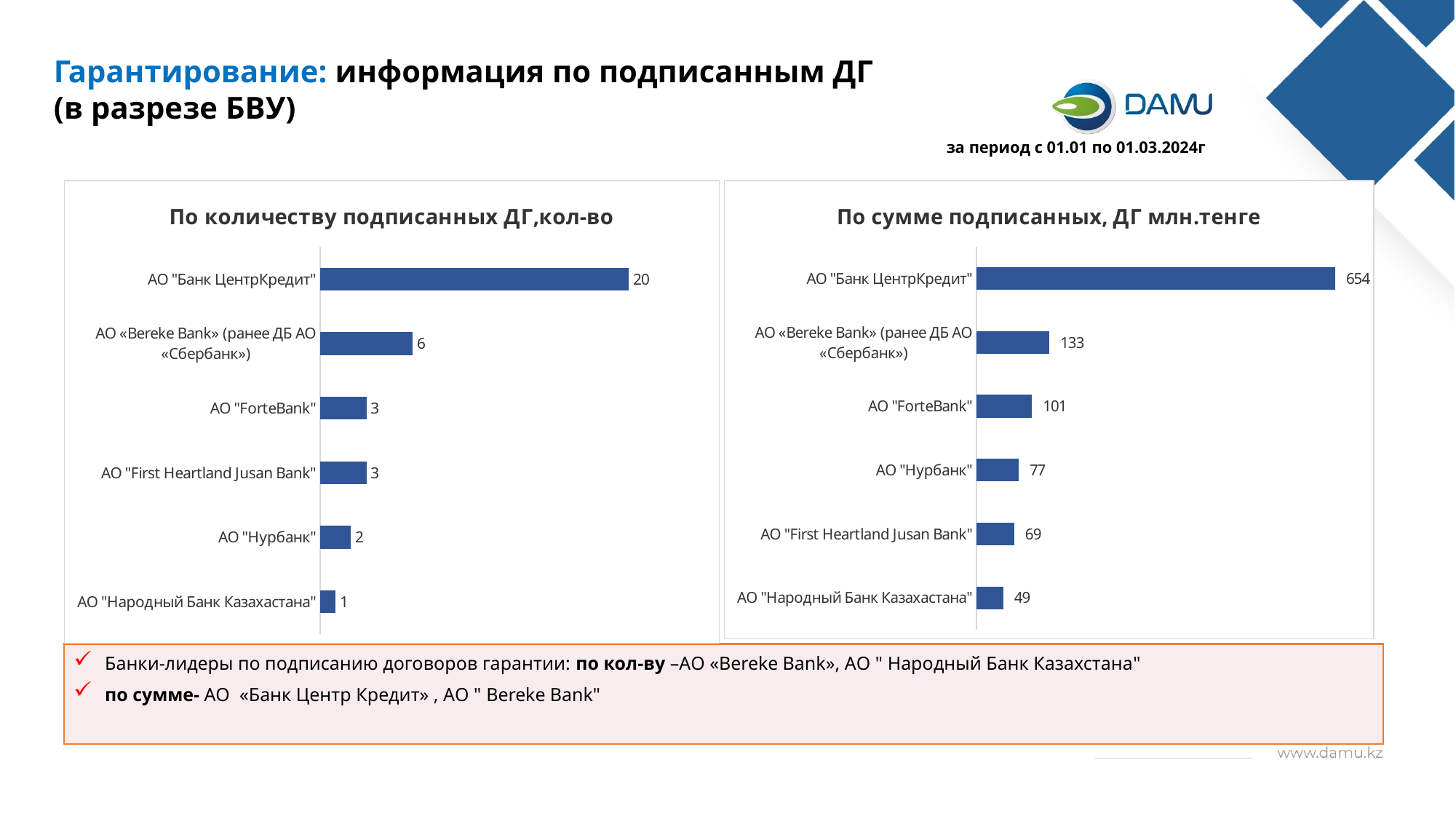
How many banks are shown in the chart "По количеству подписанных ДГ,кол-во"? 6 In the chart "По количеству подписанных ДГ,кол-во", what is the value for АО "Банк ЦентрКредит"? 20 In the chart "По сумме подписанных, ДГ млн.тенге", what is the difference between АО «Bereke Bank» and АО "Народный Банк Казахастана"? 84 What is the title of the left chart on the slide? По количеству подписанных ДГ,кол-во In the chart "По сумме подписанных, ДГ млн.тенге", which is larger: АО "Нурбанк" or АО "First Heartland Jusan Bank"? АО "Нурбанк" In the chart "По количеству подписанных ДГ,кол-во", what is the value for АО "Нурбанк"? 2 What type of chart is "По сумме подписанных, ДГ млн.тенге"? bar chart In the chart "По количеству подписанных ДГ,кол-во", which bank has the lowest value? АО "Народный Банк Казахастана" In the chart "По сумме подписанных, ДГ млн.тенге", which bank has the highest value? АО "Банк ЦентрКредит" In the chart "По сумме подписанных, ДГ млн.тенге", what is the value for АО "Нурбанк"? 77 In the chart "По количеству подписанных ДГ,кол-во", what is the difference between АО "Банк ЦентрКредит" and АО «Bereke Bank»? 14 In the chart "По сумме подписанных, ДГ млн.тенге", what is the value for АО "ForteBank"? 101